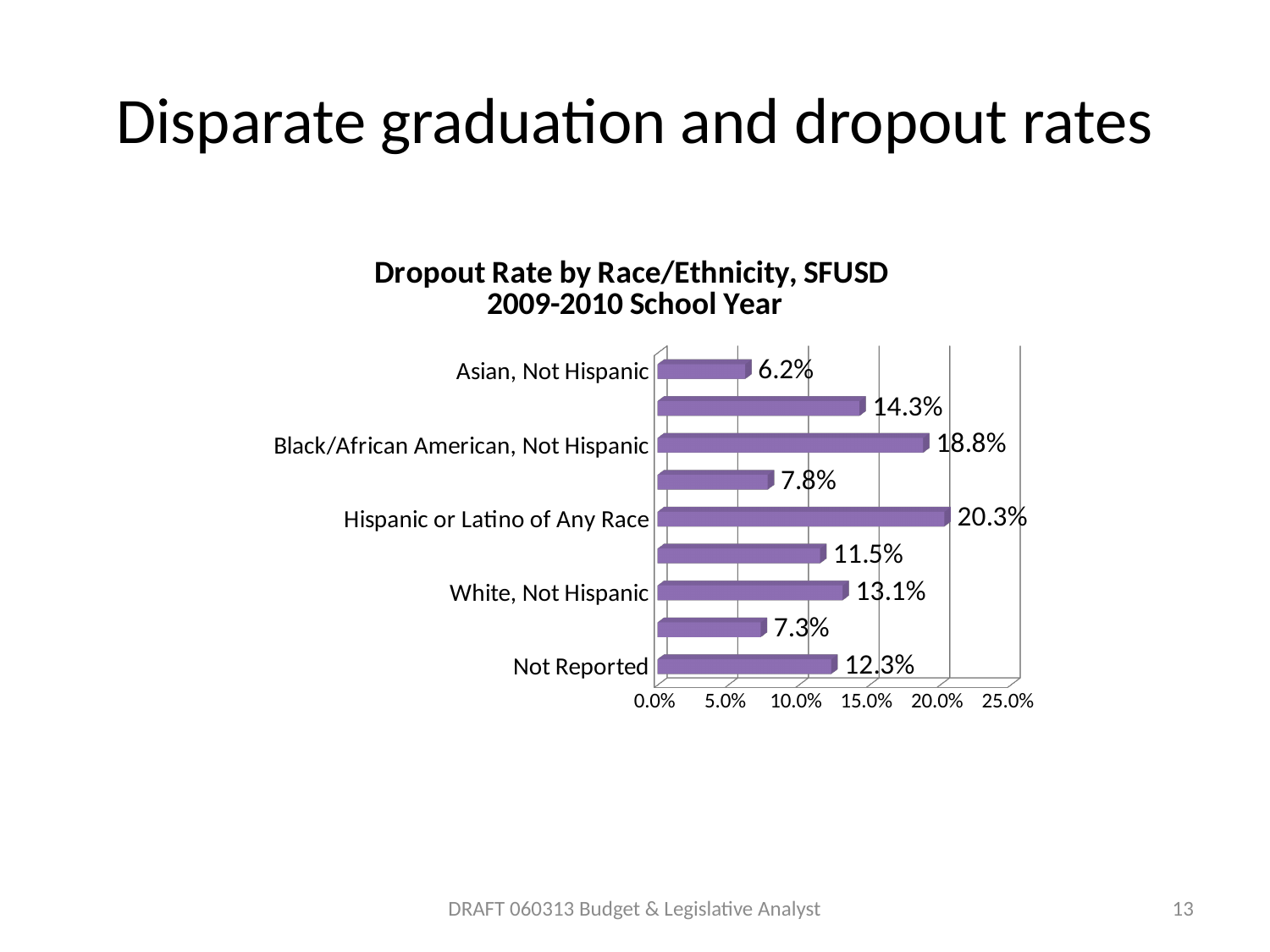
What is the dropout rate for White, Not Hispanic students? 13.1% Which race/ethnicity category has the lowest dropout rate? Asian, Not Hispanic What is the difference between the dropout rates for Hispanic or Latino of Any Race and Asian, Not Hispanic? 14.1% What is the difference between the dropout rates for Black/African American, Not Hispanic and White, Not Hispanic? 5.7% What kind of chart is shown on the slide? Bar chart Which race/ethnicity category has the highest dropout rate? Hispanic or Latino of Any Race What is the dropout rate for the Not Reported category? 12.3% What is the dropout rate for Black/African American, Not Hispanic students? 18.8% What is the dropout rate for Hispanic or Latino of Any Race students? 20.3% How many bars are plotted in the chart? 9 What is the dropout rate for Asian, Not Hispanic students? 6.2% Which has a higher dropout rate, White, Not Hispanic or Not Reported? White, Not Hispanic